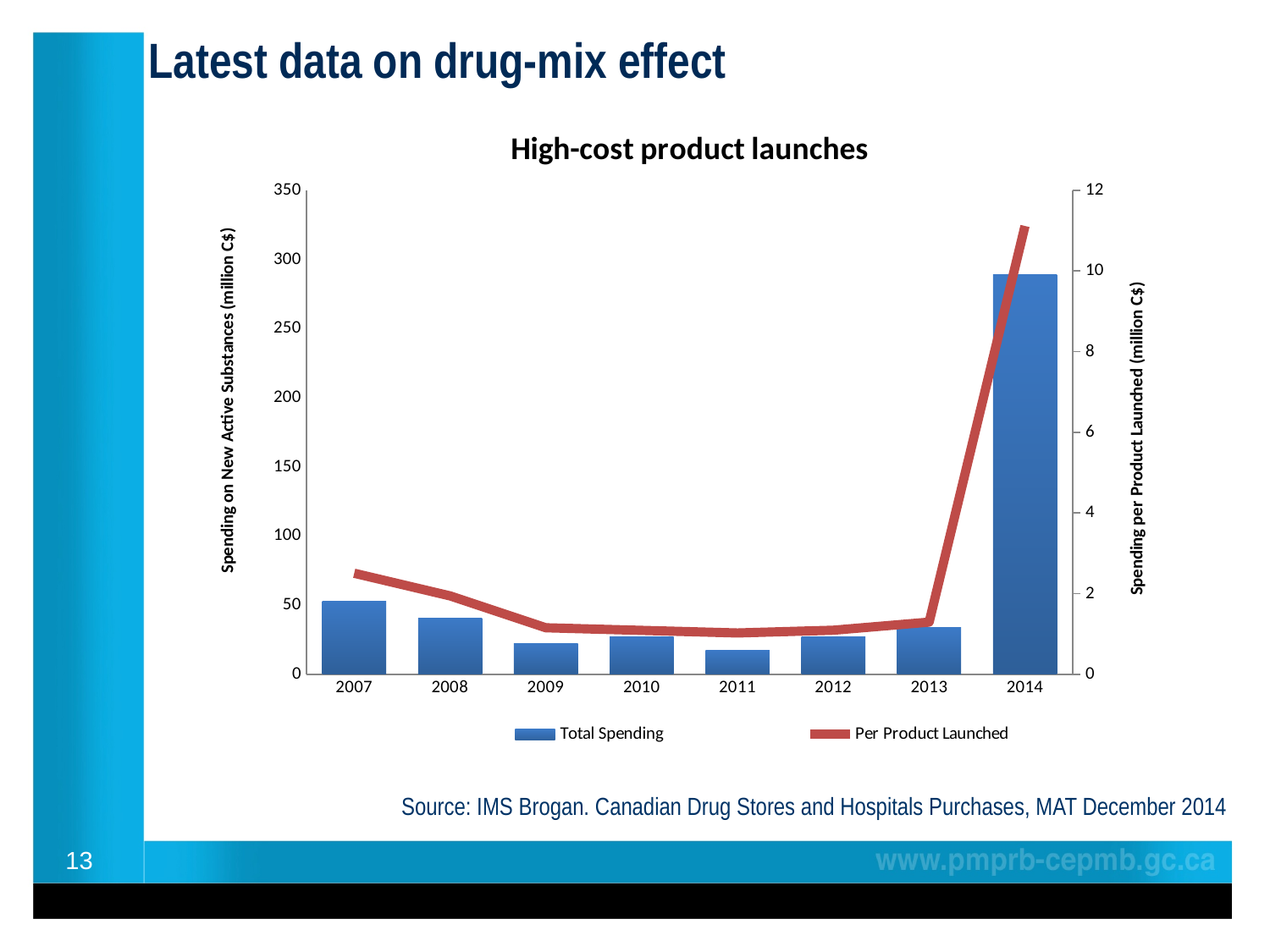
Is the Total Spending value for 2014 greater or less than 250? greater Does the Per Product Launched line rise or fall from 2007 to 2009? fall Which year has the lowest Total Spending? 2011 What kind of chart is shown on the slide? A combined bar and line chart Which year has the highest Total Spending? 2014 How many series does the legend list? 2 Is the Total Spending value for 2007 greater or less than 100? less Is the Per Product Launched value for 2014 greater or less than 10? greater Which year has the larger Total Spending, 2007 or 2008? 2007 How many years are shown on the x axis of the chart? 8 Which year has the highest value for Per Product Launched? 2014